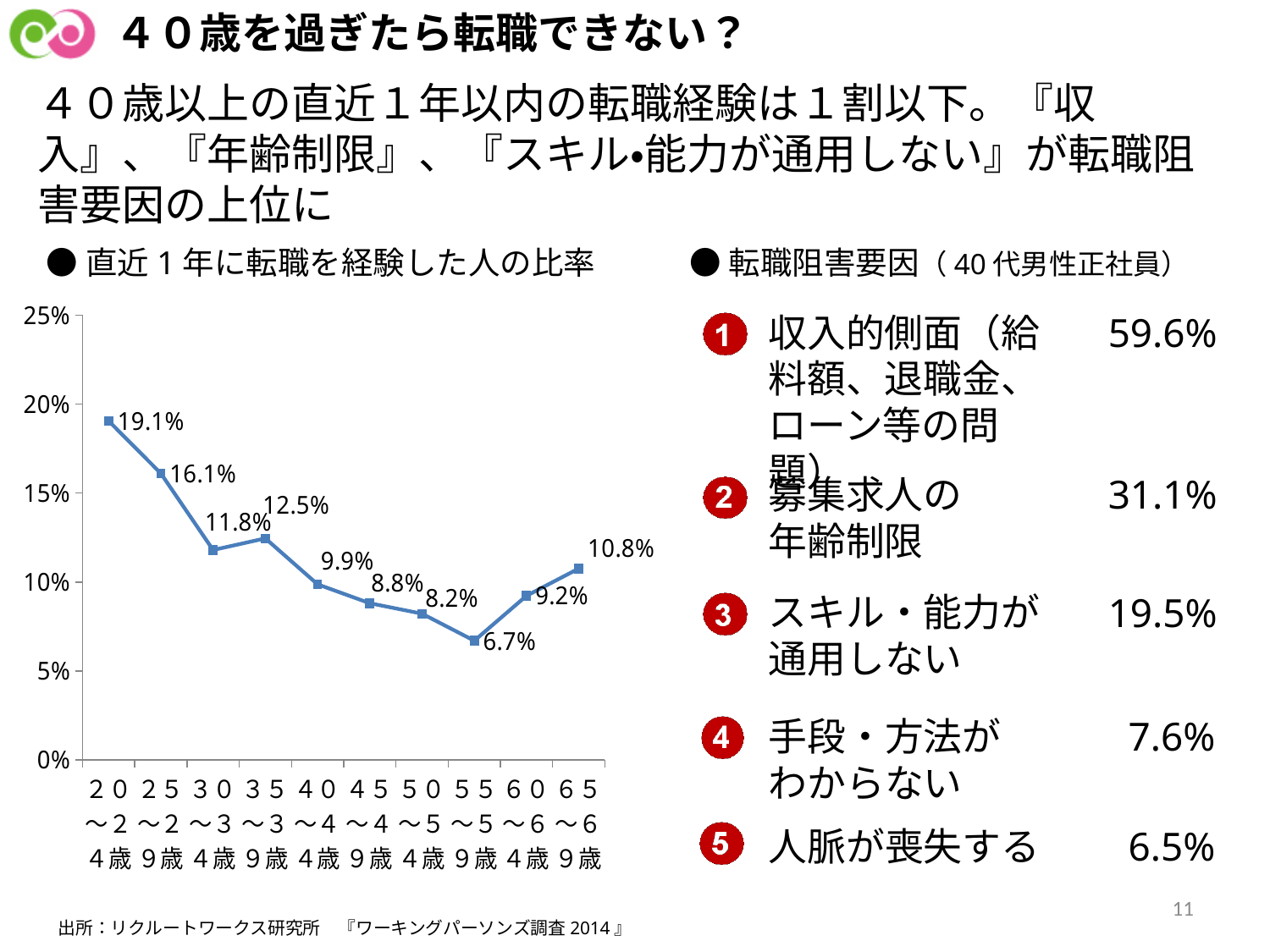
Is the value for 40～44歳 in the line chart greater or less than 10%? less What is the value for the 65～69歳 age group in the line chart? 10.8% What is the value for the 20～24歳 age group in the line chart? 19.1% What is the maximum value shown on the y axis of the line chart? 25% Do the values in the line chart generally rise or fall from 20～24歳 to 55～59歳? fall Which age group has the highest value in the line chart? 20～24歳 What is the value for the 55～59歳 age group in the line chart? 6.7% Which is larger in the line chart, the value for 30～34歳 or 35～39歳? 35～39歳 What kind of chart is used to show 直近1年に転職を経験した人の比率? line chart Which age group has the lowest value in the line chart? 55～59歳 How many age groups are plotted in the line chart? 10 What is the difference between the values for 20～24歳 and 25～29歳 in the line chart? 3.0%